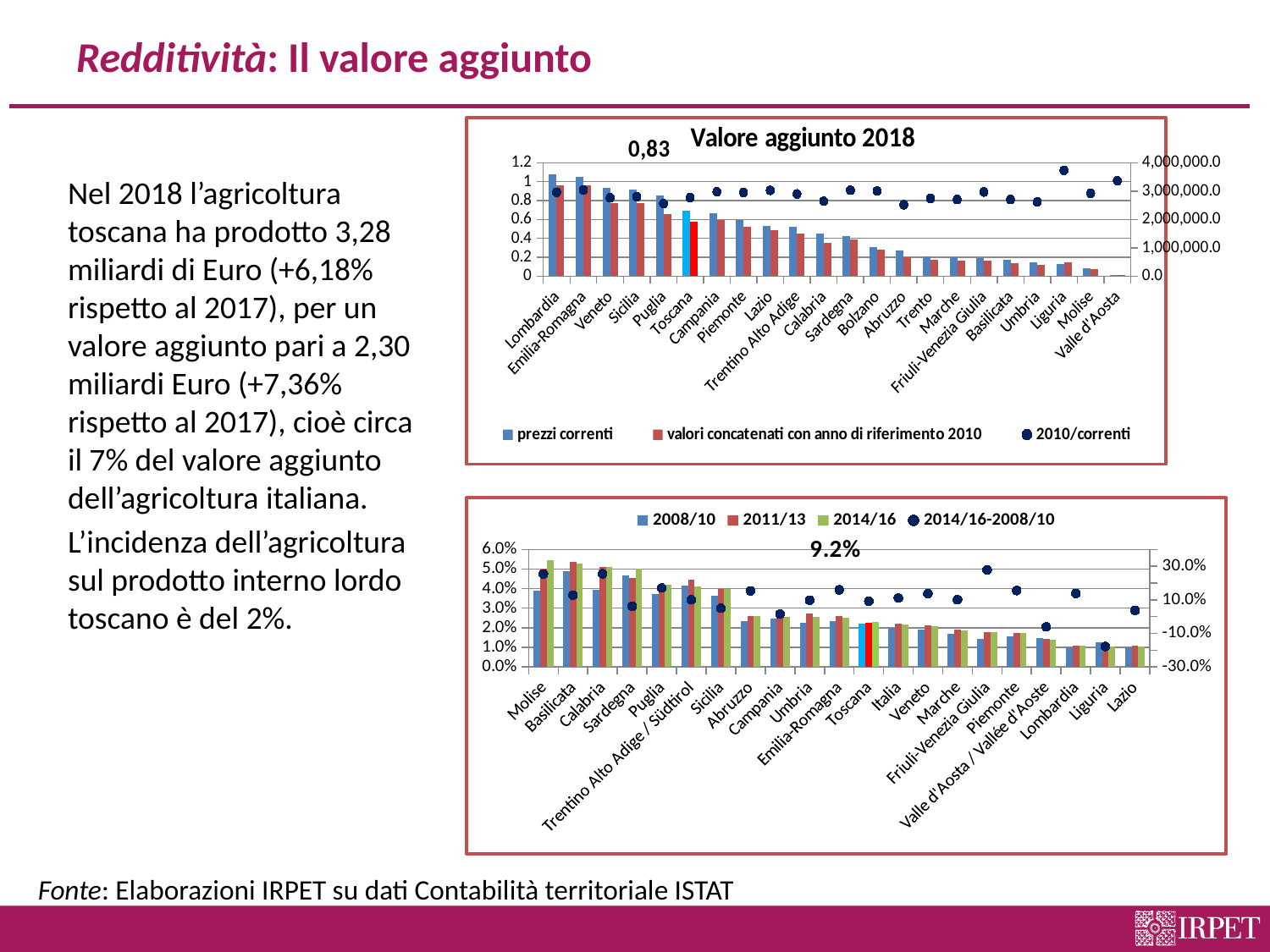
In the bottom chart, is the 2014/16 value for Molise greater or less than 5.0%? greater In the top chart 'Valore aggiunto 2018', which region has the lowest prezzi correnti bar? Valle d'Aosta In the bottom chart, how many categories are shown on the x axis? 21 In the top chart 'Valore aggiunto 2018', what value is labelled for Toscana's 2010/correnti point? 0,83 In the bottom chart, which has the larger 2008/10 value, Molise or Lazio? Molise In the top chart 'Valore aggiunto 2018', is the prezzi correnti value for Lombardia greater or less than 1? greater In the top chart 'Valore aggiunto 2018', how many regions are shown on the x axis? 22 What is the title of the top chart? Valore aggiunto 2018 In the bottom chart, how many series does the legend list? 4 In the top chart 'Valore aggiunto 2018', how many series does the legend list? 3 In the top chart 'Valore aggiunto 2018', do the prezzi correnti bars rise or fall moving from left to right along the x axis? fall In the bottom chart, what value is labelled for Toscana's 2014/16-2008/10 point? 9.2%